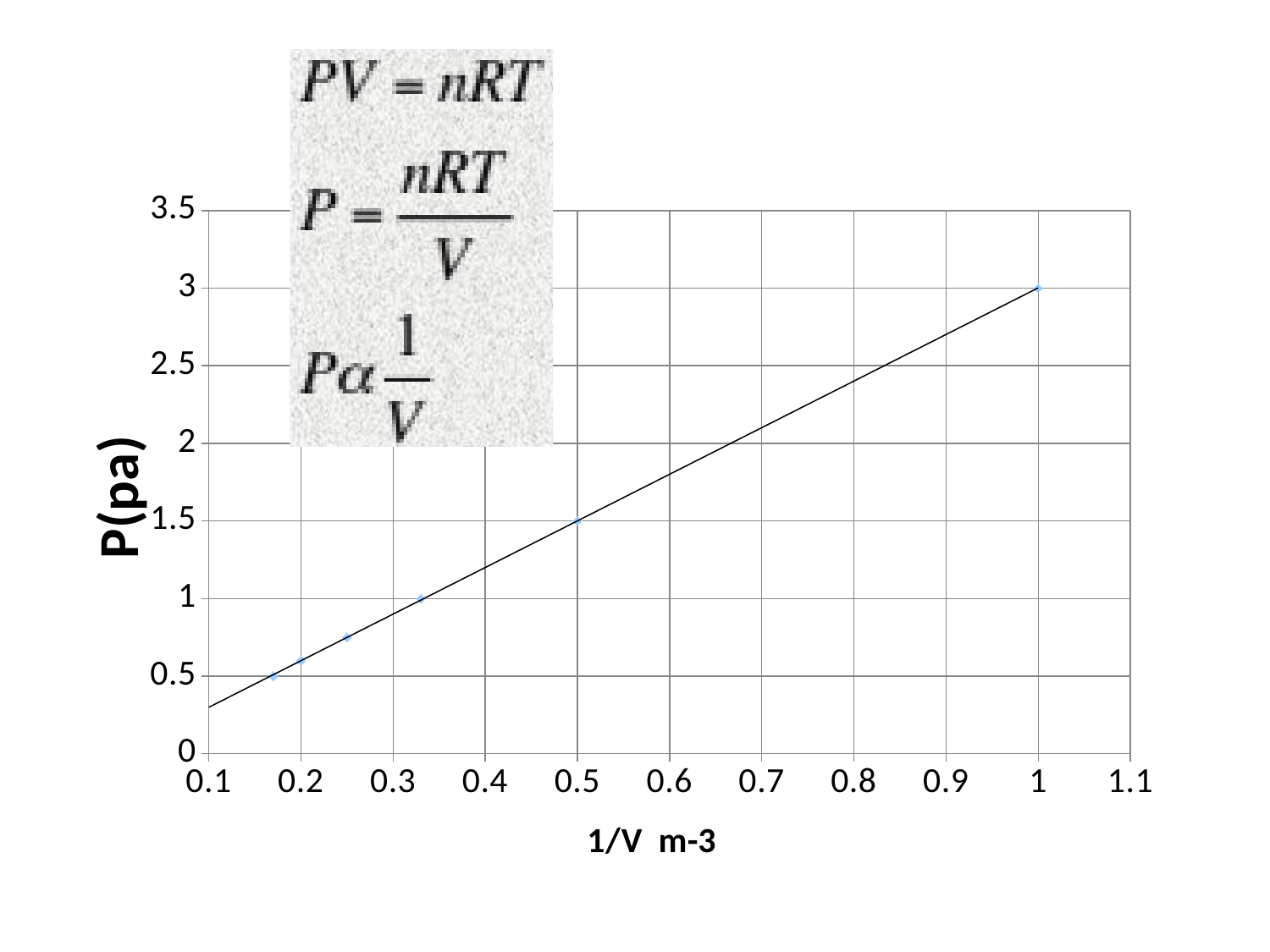
Is the value of P at 1/V = 0.25 greater or less than 1? less How many data points are plotted on the chart? 6 Which has a larger P value: the point at 1/V = 0.5 or the point at 1/V = 0.33? 1/V = 0.5 What is the value of P at 1/V = 1? 3 What is the x-axis title of the chart? 1/V m-3 What type of chart is shown on the slide? scatter chart with a trend line What is the difference between the P values at 1/V = 1 and 1/V = 0.5? 1.5 Does P rise or fall as 1/V increases along the x axis? rises Is the value of P at 1/V = 1 greater or less than 2.5? greater At which value of 1/V is P highest? 1 What is the value of P at 1/V = 0.5? 1.5 What is the y-axis title of the chart? P(pa)